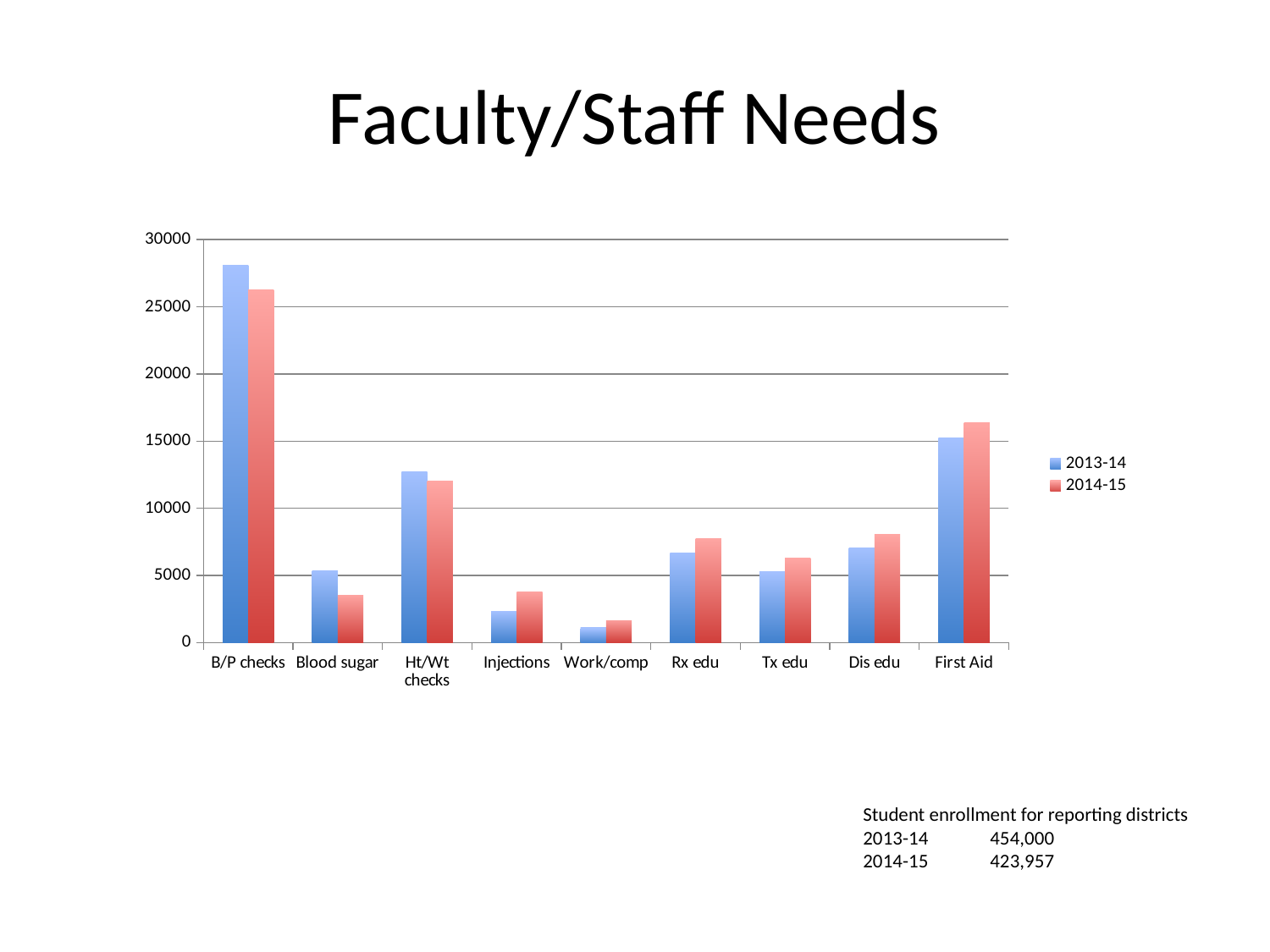
Is the 2014-15 value for First Aid greater or less than 15000? greater For Injections, which series has the larger value, 2013-14 or 2014-15? 2014-15 What kind of chart is shown on the slide? bar chart Is the 2013-14 value for B/P checks greater or less than 25000? greater Is the 2013-14 value for Ht/Wt checks greater or less than 10000? greater Which category has the highest value for the 2013-14 series? B/P checks Which category has the lowest value for the 2014-15 series? Work/comp For Blood sugar, which series has the larger value, 2013-14 or 2014-15? 2013-14 What is the title of the slide containing the chart? Faculty/Staff Needs How many categories are shown along the x axis? 9 How many series does the legend list? 2